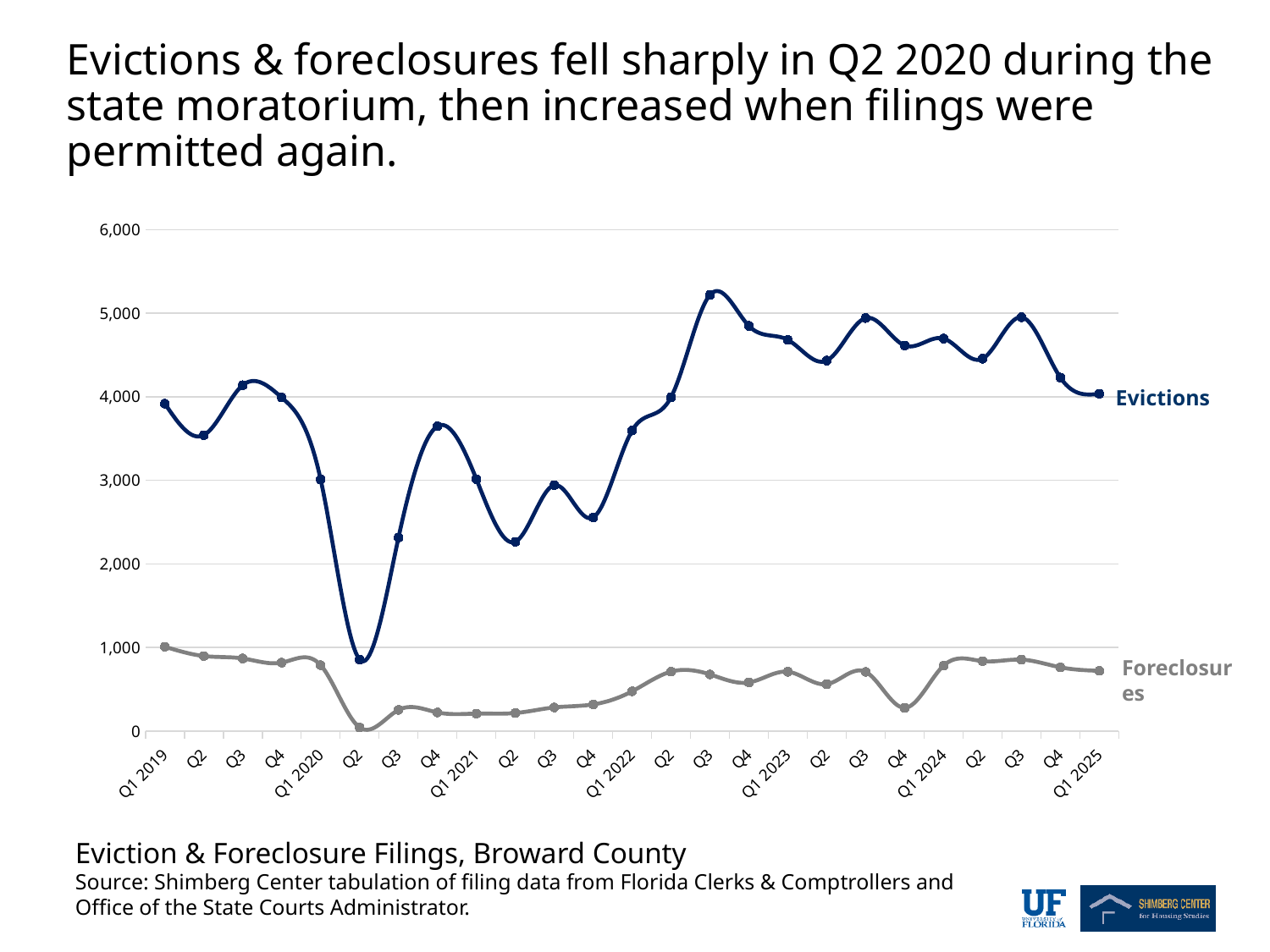
Is the value for Evictions in Q3 2022 greater or less than 5,000? greater What is the title of the chart given below the plot? Eviction & Foreclosure Filings, Broward County Is the value for Foreclosures in Q4 2023 greater or less than 500? less What kind of chart is shown on the slide? Line chart How many quarterly data points does each line have, from Q1 2019 to Q1 2025? 25 Do Evictions rise or fall between Q1 2020 and Q2 2020? Fall Is the value for Evictions in Q2 2020 greater or less than 1,000? less In which quarter do Evictions reach their lowest value? Q2 2020 Which series has the higher value in Q1 2025, Evictions or Foreclosures? Evictions In which quarter do Foreclosures reach their lowest value? Q2 2020 How many series are plotted on the chart? 2 In which quarter do Evictions reach their highest value? Q3 2022